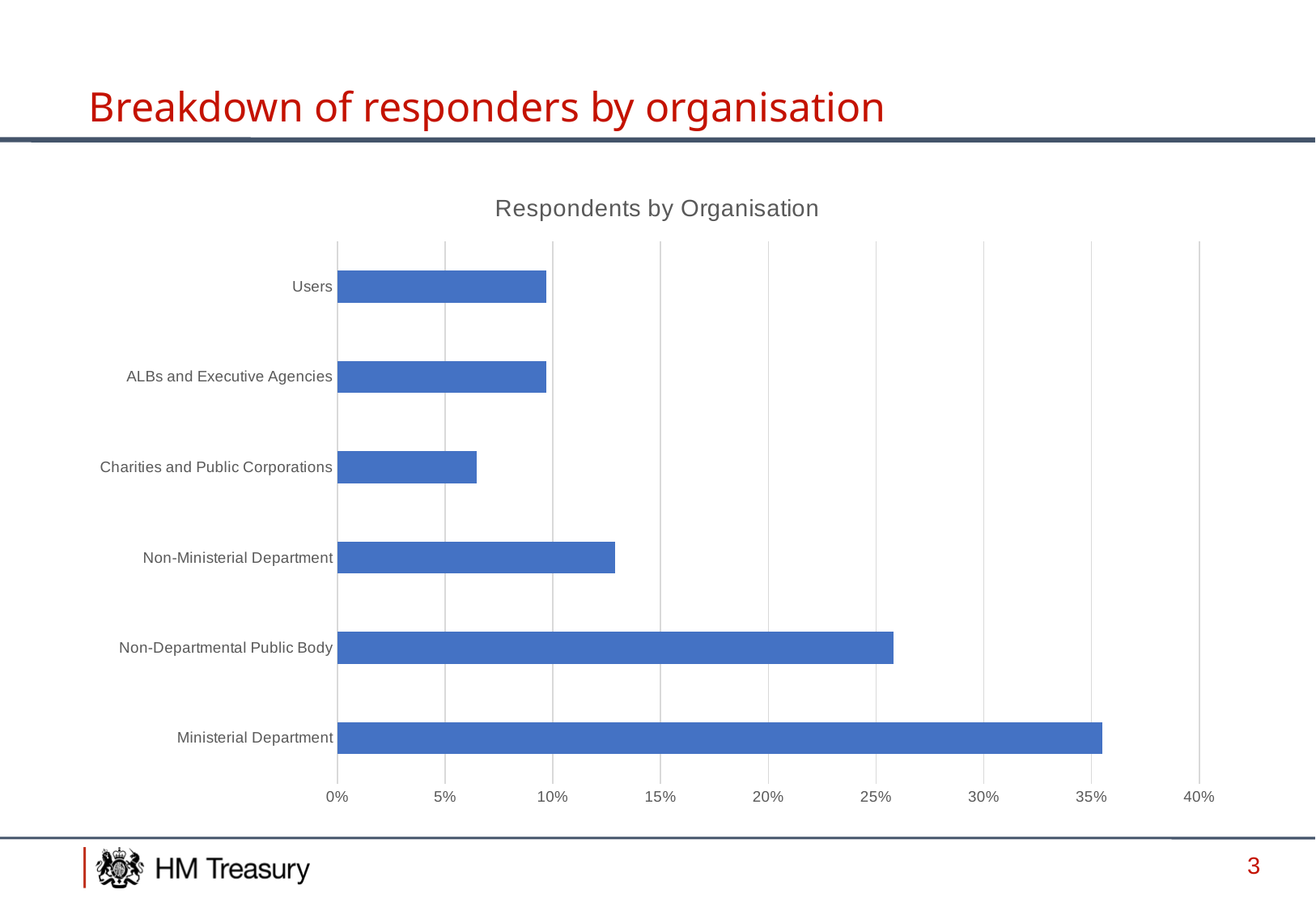
Which is larger, the value for Charities and Public Corporations or the value for ALBs and Executive Agencies? ALBs and Executive Agencies Is the value for Charities and Public Corporations greater or less than 5%? greater Which organisation category has the highest share of respondents? Ministerial Department Is the value for Non-Ministerial Department greater or less than 15%? less What is the title of the chart? Respondents by Organisation Which organisation category has the lowest share of respondents? Charities and Public Corporations Which is larger, the value for Non-Departmental Public Body or the value for Non-Ministerial Department? Non-Departmental Public Body What kind of chart is shown on the slide? bar chart How many organisation categories are shown in the chart? 6 Is the value for Non-Departmental Public Body greater or less than 25%? greater